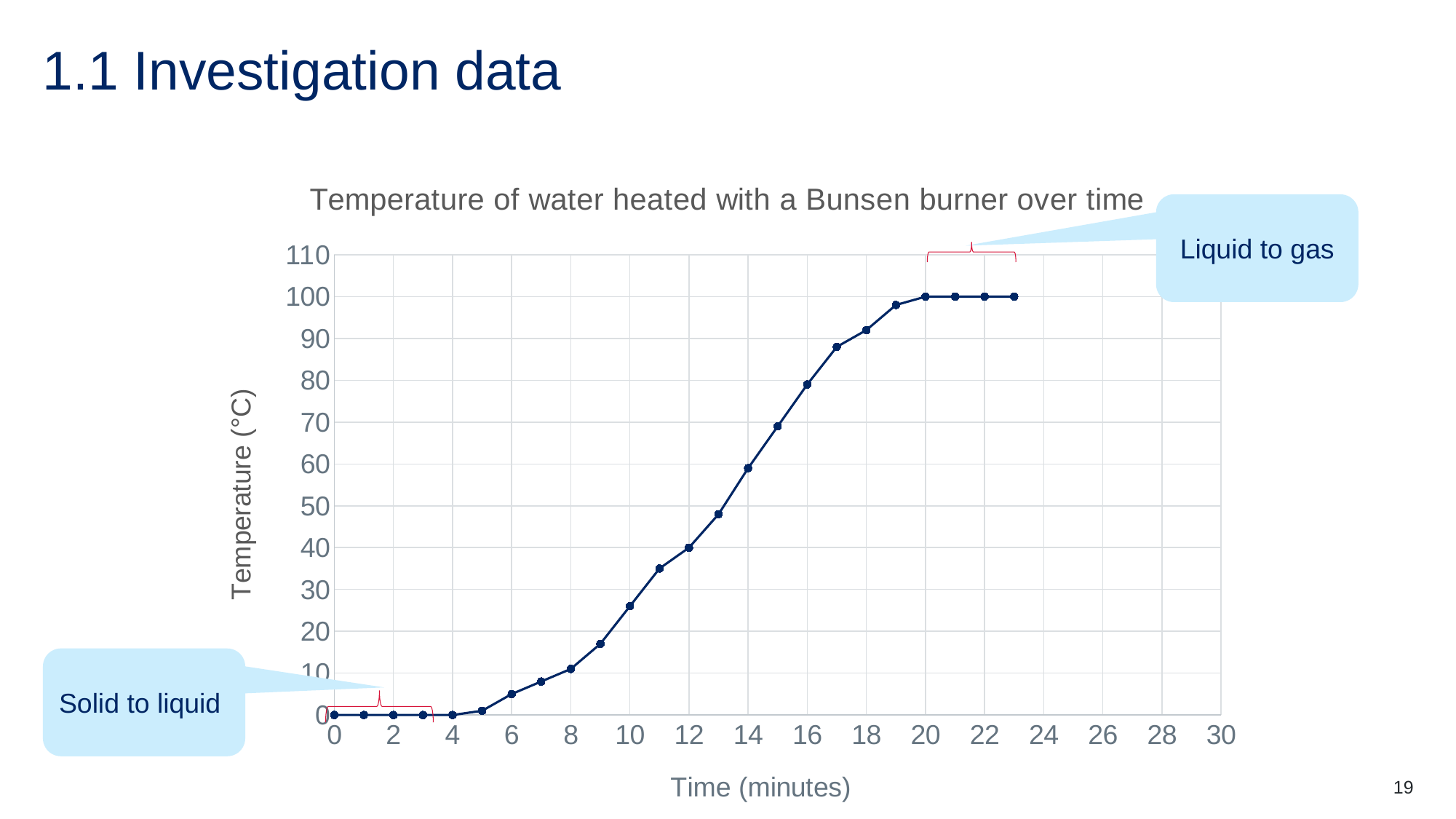
What is the temperature at 0 minutes? 0 What is the title of the chart? Temperature of water heated with a Bunsen burner over time Overall, does the temperature rise or fall as time increases? rises What is the difference between the temperature at 20 minutes and at 0 minutes? 100 What is the highest temperature reached on the chart? 100 Is the temperature at 14 minutes greater or less than 50? greater What kind of chart is shown on the slide? line chart Is the temperature at 10 minutes greater or less than 20? greater What is the temperature at 20 minutes? 100 Which is higher, the temperature at 17 minutes or at 9 minutes? 17 minutes What is the temperature at 12 minutes? 40 Is the temperature at 8 minutes greater or less than 20? less